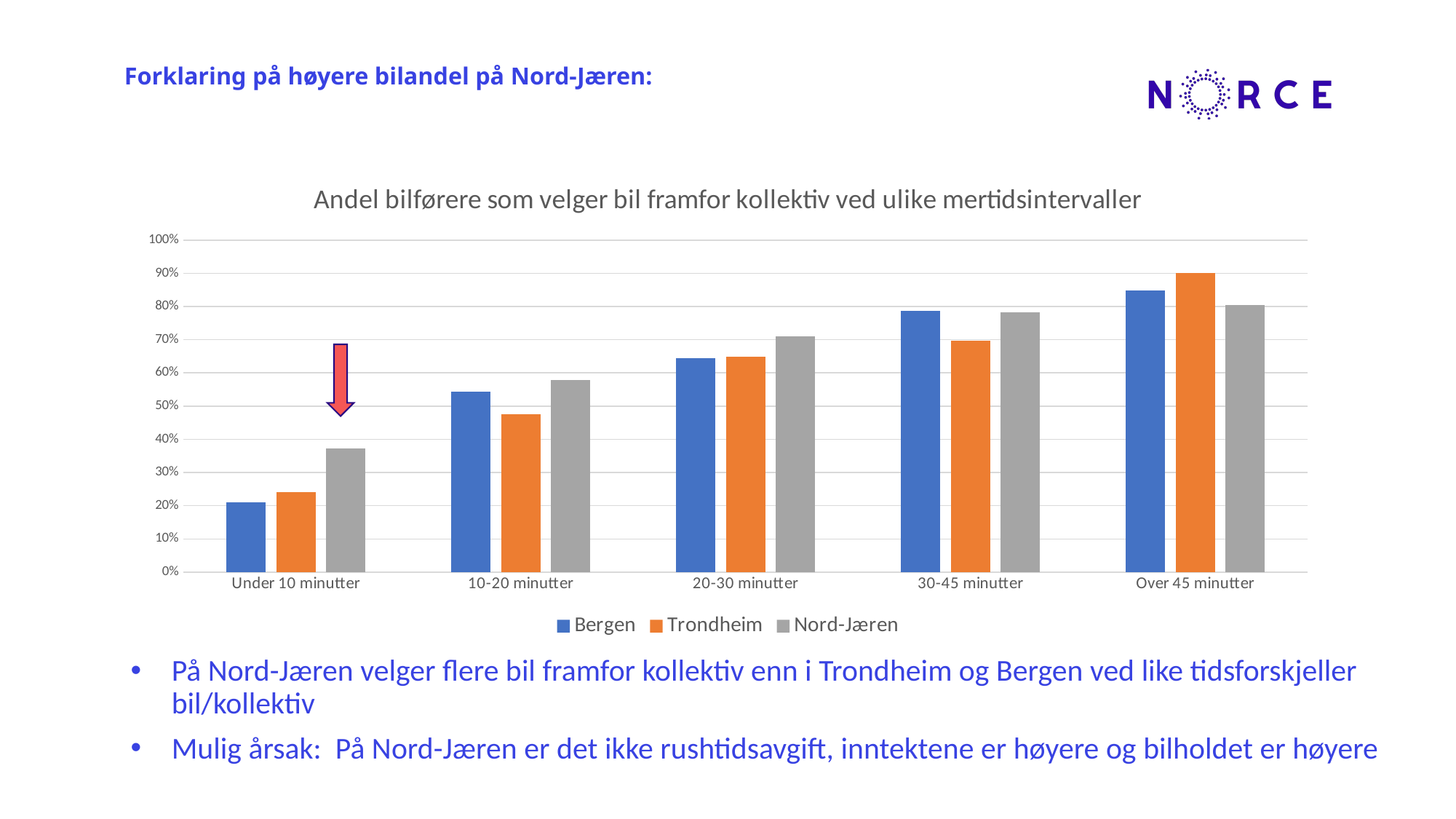
In the 'Over 45 minutter' category, which is larger: Trondheim or Nord-Jæren? Trondheim What kind of chart is shown on the slide? Bar chart In the 'Under 10 minutter' category, which is larger: Bergen or Nord-Jæren? Nord-Jæren Is the value for Trondheim in the '10-20 minutter' category greater or less than 50%? less In which category is the Bergen value lowest? Under 10 minutter Do the Bergen values rise or fall as the time intervals increase along the x axis? Rise Is the value for Nord-Jæren in the 'Under 10 minutter' category greater or less than 30%? greater How many time-interval categories are shown on the x axis? 5 How many series does the legend list? 3 In which category is the Trondheim value highest? Over 45 minutter What is the title of the chart? Andel bilførere som velger bil framfor kollektiv ved ulike mertidsintervaller